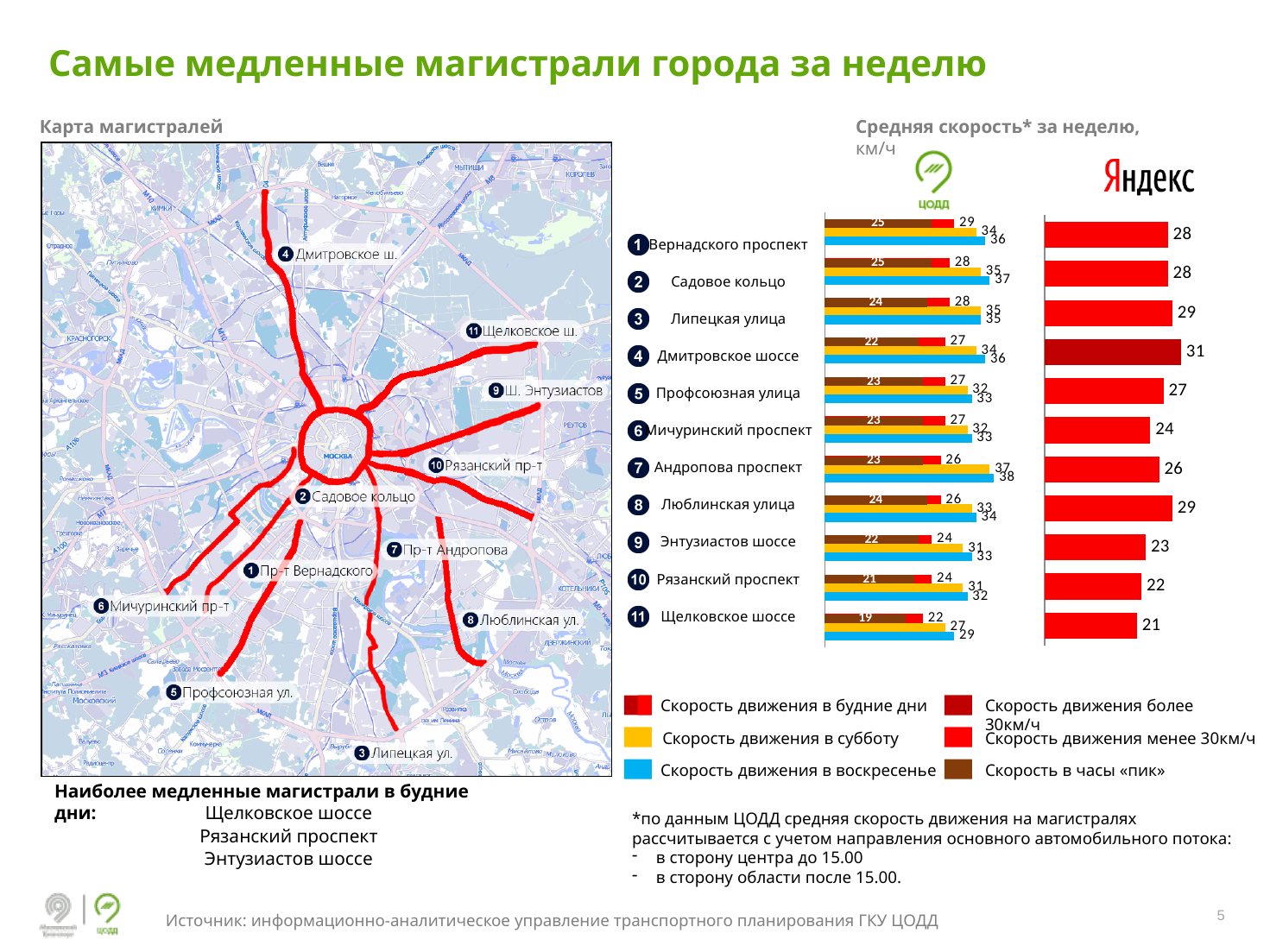
How many roads (categories) are plotted in the ЦОДД chart? 11 In the Яндекс chart, which road has the lowest average speed? Щелковское шоссе In the Яндекс chart, which has the higher value: Липецкая улица or Энтузиастов шоссе? Липецкая улица In the legend, which colour represents Скорость движения в воскресенье (Sunday speed)? Blue In the ЦОДД chart, what is the Sunday speed (Скорость движения в воскресенье) for Андропова проспект? 38 In the Яндекс chart, what is the average weekly speed for Дмитровское шоссе? 31 What type of chart is the Яндекс chart? Bar chart In the Яндекс chart, what is the difference between the values for Дмитровское шоссе and Щелковское шоссе? 10 In the ЦОДД chart, what is the peak-hour speed (Скорость в часы «пик») for Щелковское шоссе? 19 In the ЦОДД chart, what is the weekday speed (Скорость движения в будние дни) for Щелковское шоссе? 22 In the ЦОДД chart, what is the difference between the Sunday speed and the weekday speed for Вернадского проспект? 7 In the Яндекс chart, which road has the highest average speed? Дмитровское шоссе